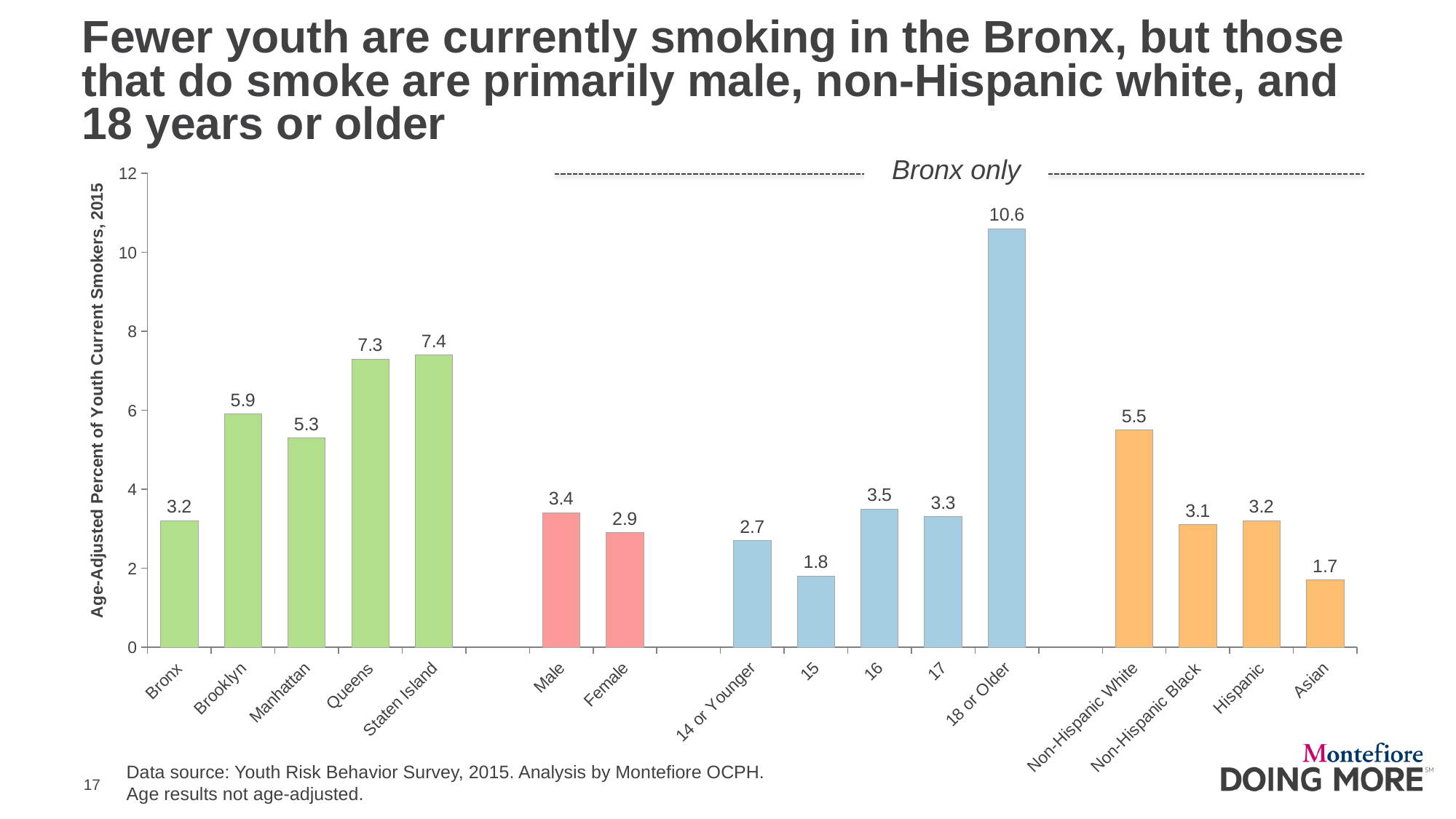
How many categories are shown on the x axis? 16 What is the difference between the values for 18 or Older and 17? 7.3 Which is larger, the value for Male or the value for Female? Male What is the value for Non-Hispanic White? 5.5 What is the y-axis label of the chart? Age-Adjusted Percent of Youth Current Smokers, 2015 What is the value for Staten Island? 7.4 What is the difference between the values for Staten Island and Bronx? 4.2 What kind of chart is shown on the slide? bar chart What is the value for 18 or Older? 10.6 Which category has the lowest value on the chart? Asian Which category has the highest value on the chart? 18 or Older Is the value for Queens greater or less than 6? greater